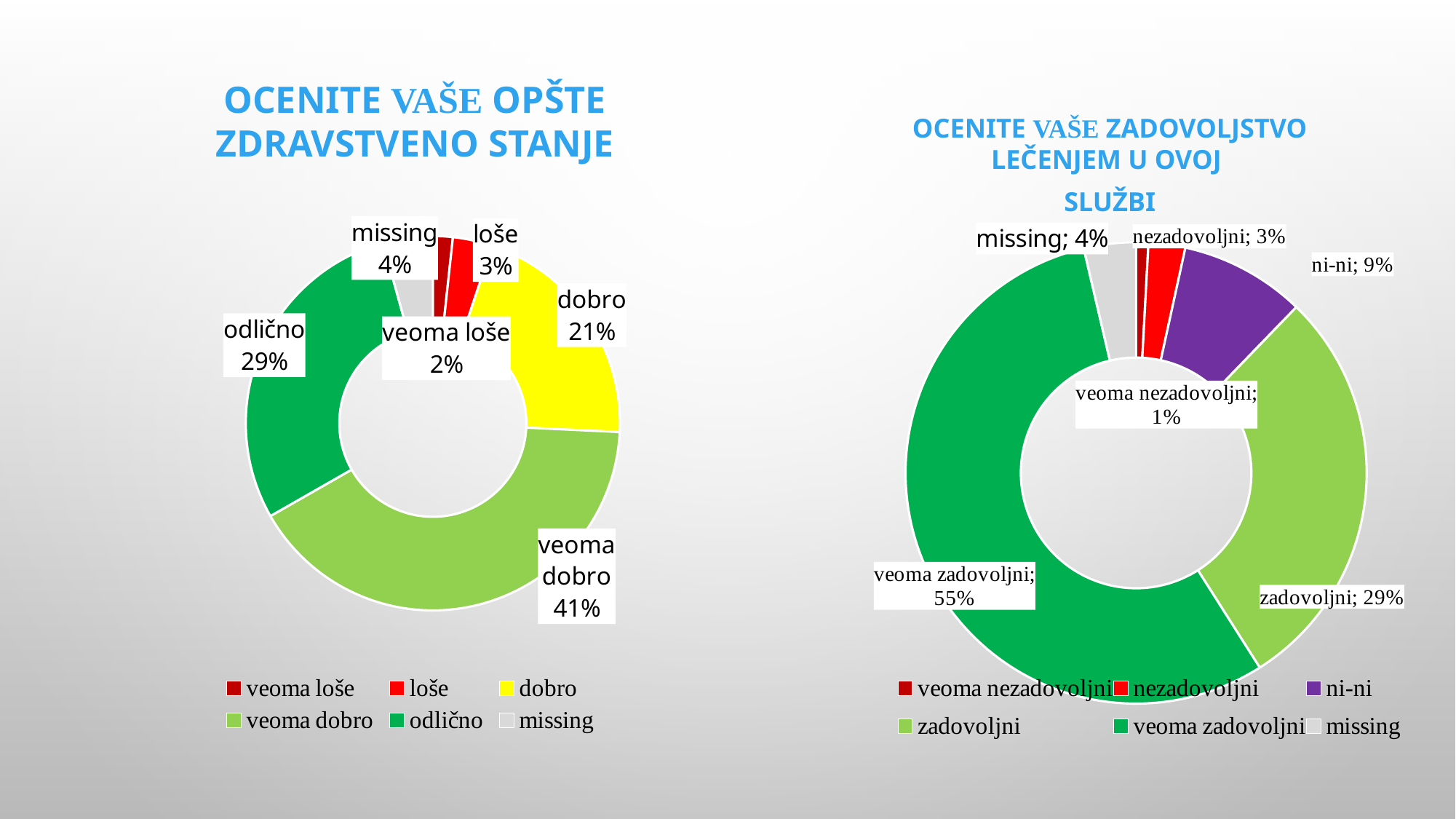
In the right chart (OCENITE VAŠE ZADOVOLJSTVO LEČENJEM U OVOJ SLUŽBI), which is larger: 'ni-ni' or 'nezadovoljni'? ni-ni In the right chart (OCENITE VAŠE ZADOVOLJSTVO LEČENJEM U OVOJ SLUŽBI), which category has the smallest share? veoma nezadovoljni In the right chart (OCENITE VAŠE ZADOVOLJSTVO LEČENJEM U OVOJ SLUŽBI), what percentage is shown for 'zadovoljni'? 29% In the right chart (OCENITE VAŠE ZADOVOLJSTVO LEČENJEM U OVOJ SLUŽBI), what colour is the 'ni-ni' slice? Purple In the left chart (OCENITE VAŠE OPŠTE ZDRAVSTVENO STANJE), how many categories does the legend list? 6 In the right chart (OCENITE VAŠE ZADOVOLJSTVO LEČENJEM U OVOJ SLUŽBI), what is the difference between 'veoma zadovoljni' and 'zadovoljni'? 26% In the right chart (OCENITE VAŠE ZADOVOLJSTVO LEČENJEM U OVOJ SLUŽBI), which category has the largest share? veoma zadovoljni In the left chart (OCENITE VAŠE OPŠTE ZDRAVSTVENO STANJE), what kind of chart is shown? Doughnut (pie) chart In the left chart (OCENITE VAŠE OPŠTE ZDRAVSTVENO STANJE), which category has the largest share? veoma dobro In the left chart (OCENITE VAŠE OPŠTE ZDRAVSTVENO STANJE), which category has the smallest share? veoma loše In the left chart (OCENITE VAŠE OPŠTE ZDRAVSTVENO STANJE), what is the difference between 'odlično' and 'dobro'? 8% In the left chart (OCENITE VAŠE OPŠTE ZDRAVSTVENO STANJE), what percentage is shown for 'veoma dobro'? 41%